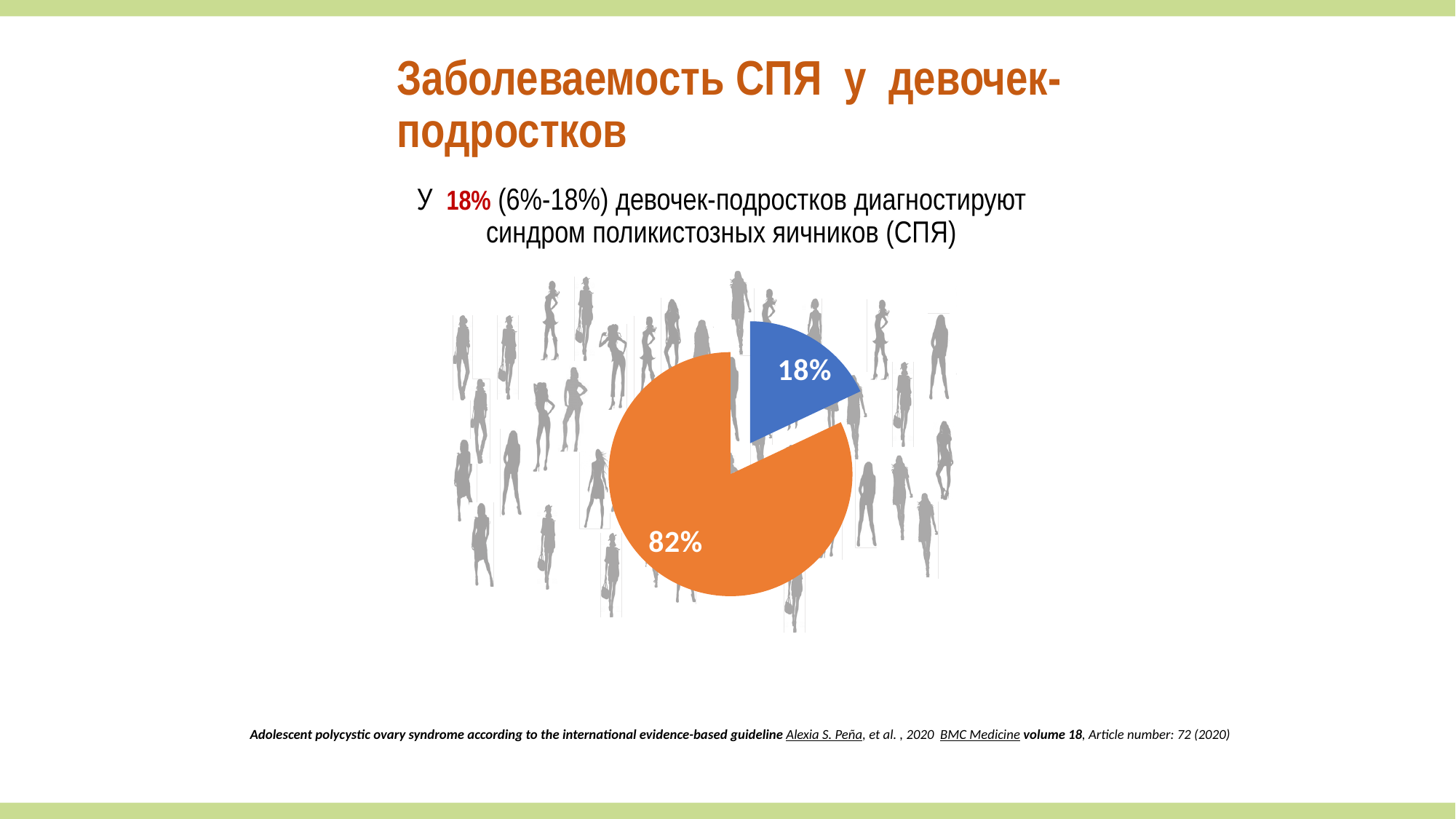
What value is labelled on the orange slice of the pie chart? 82% What is the difference between the orange slice and the blue slice in the pie chart? 64% Which slice of the pie chart is the smallest? the blue slice (18%) What share of the pie does the blue slice represent? 18% What colour is the slice labelled 82% in the pie chart? orange How many slices does the pie chart have? 2 Which slice of the pie chart is the largest? the orange slice (82%) Which is larger in the pie chart, the blue slice or the orange slice? the orange slice Is the value of the blue slice greater or less than 20%? less What do the two slices of the pie chart add up to? 100% What value is labelled on the blue slice of the pie chart? 18% What type of chart is shown on the slide? pie chart